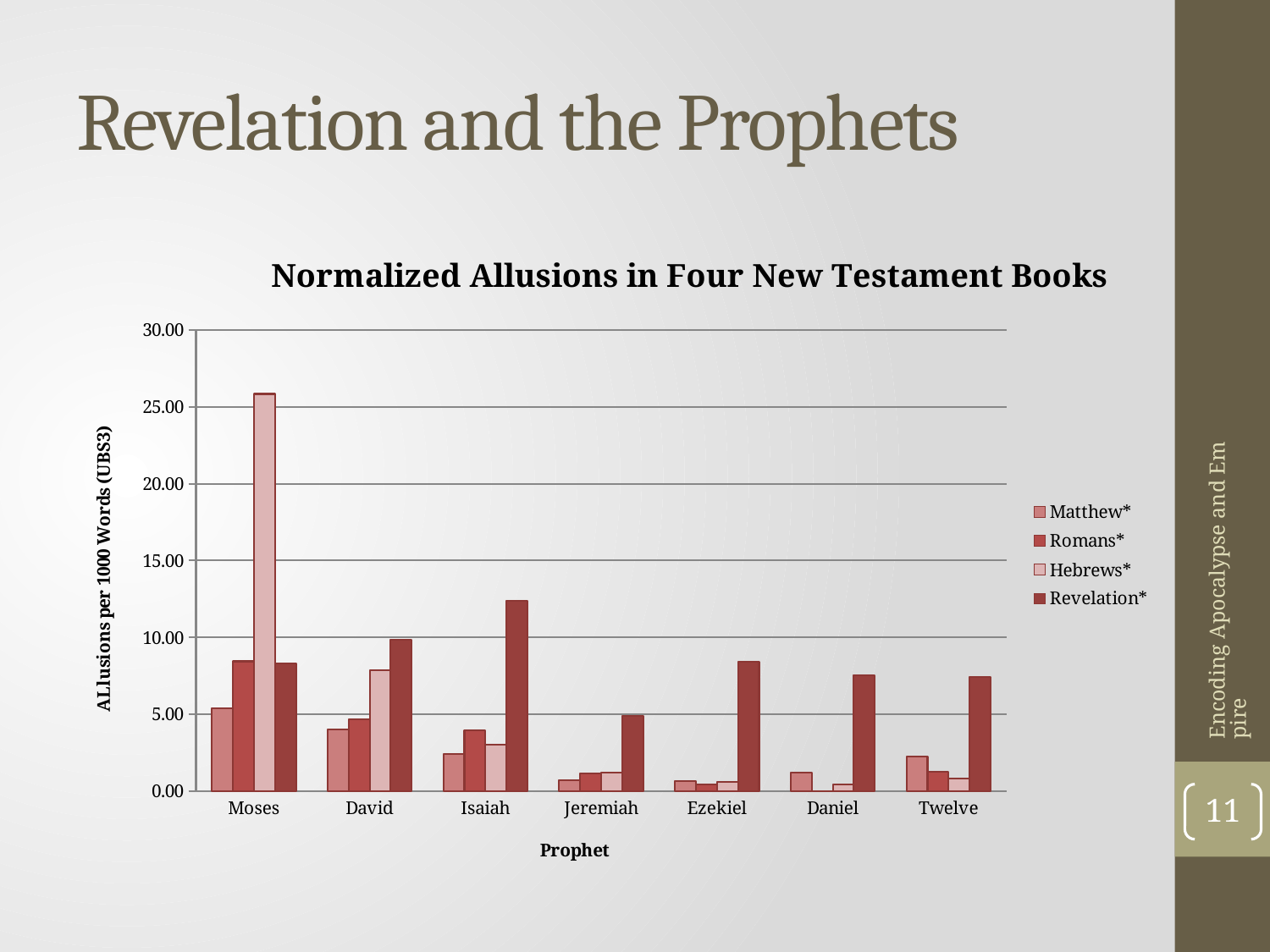
What is the title of the chart? Normalized Allusions in Four New Testament Books For Isaiah, which is larger: the Revelation* value or the Romans* value? Revelation* Which prophet has the lowest value for Revelation*? Jeremiah Is the Revelation* value for Ezekiel greater or less than 10.00? less Which prophet has the highest value for Revelation*? Isaiah How many series does the legend list? 4 Is the Hebrews* value for Moses greater or less than 20.00? greater What kind of chart is shown on the slide? bar chart For David, which is larger: the Revelation* value or the Hebrews* value? Revelation* Which prophet has the highest value for Hebrews*? Moses Is the Revelation* value for Isaiah greater or less than 10.00? greater How many prophets are shown on the x axis? 7